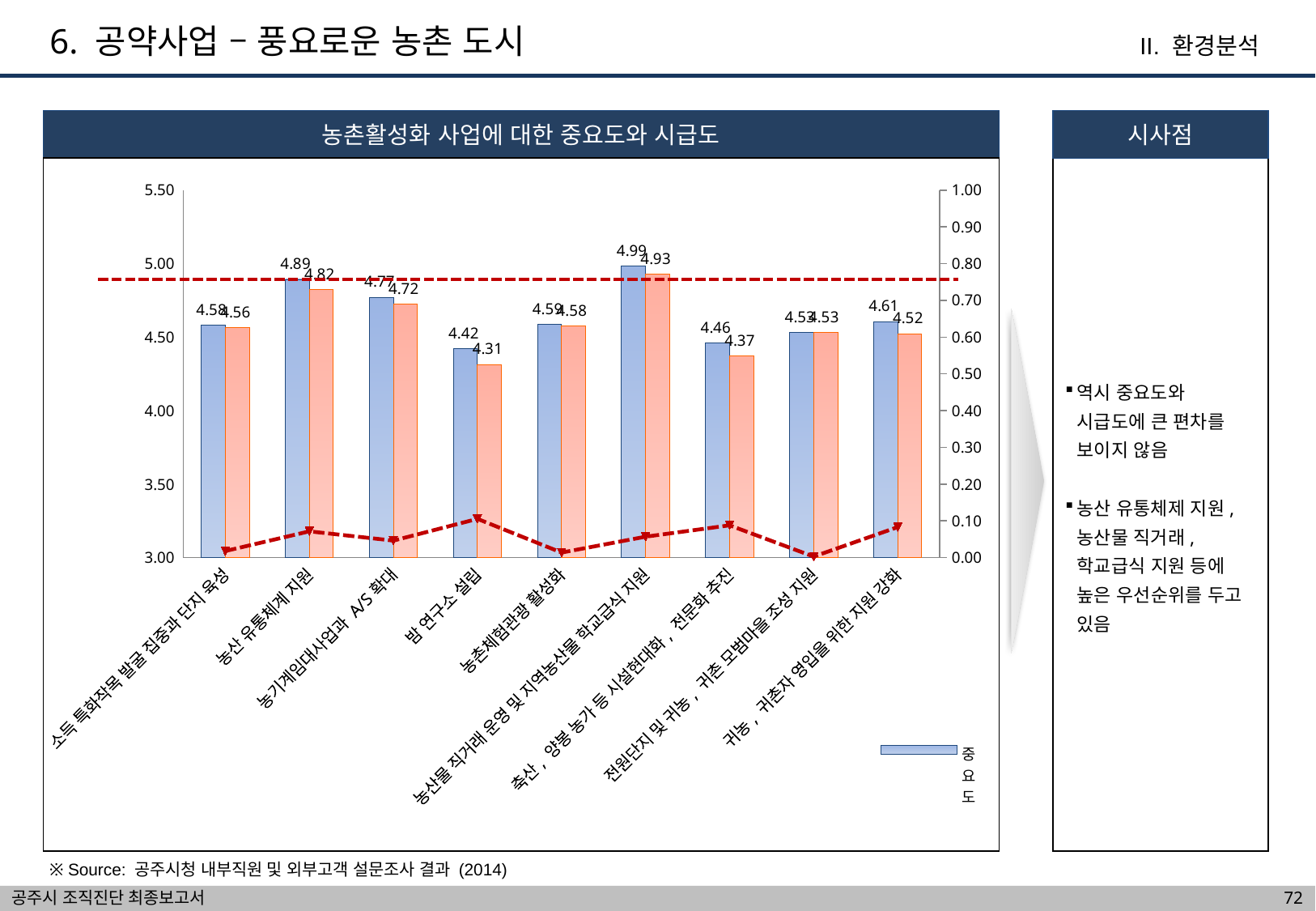
Which category has the lowest 중요도 (blue bar) value? 밤 연구소 설립 Is the 중요도 (blue bar) value for 농산물 직거래 운영 및 지역농산물 학교급식 지원 greater or less than 4.50? greater Which category has the highest 중요도 (blue bar) value? 농산물 직거래 운영 및 지역농산물 학교급식 지원 What is the title of the chart on the slide? 농촌활성화 사업에 대한 중요도와 시급도 What kind of chart is shown under the title 농촌활성화 사업에 대한 중요도와 시급도? bar and line chart What is the difference between the 중요도 (blue bar) values for 농산 유통체계 지원 and 밤 연구소 설립? 0.47 What is the 중요도 (blue bar) value for 귀농, 귀촌자 영입을 위한 지원 강화? 4.61 What is the difference between the blue bar and the orange bar for 축산, 양봉 농가 등 시설현대화, 전문화 추진? 0.09 How many categories are shown on the x axis of the chart? 9 What is the 중요도 (blue bar) value for 농산 유통체계 지원? 4.89 Which is larger, the 중요도 (blue bar) value for 농기계임대사업과 A/S 확대 or for 농촌체험관광 활성화? 농기계임대사업과 A/S 확대 What is the value of the orange bar for 밤 연구소 설립? 4.31